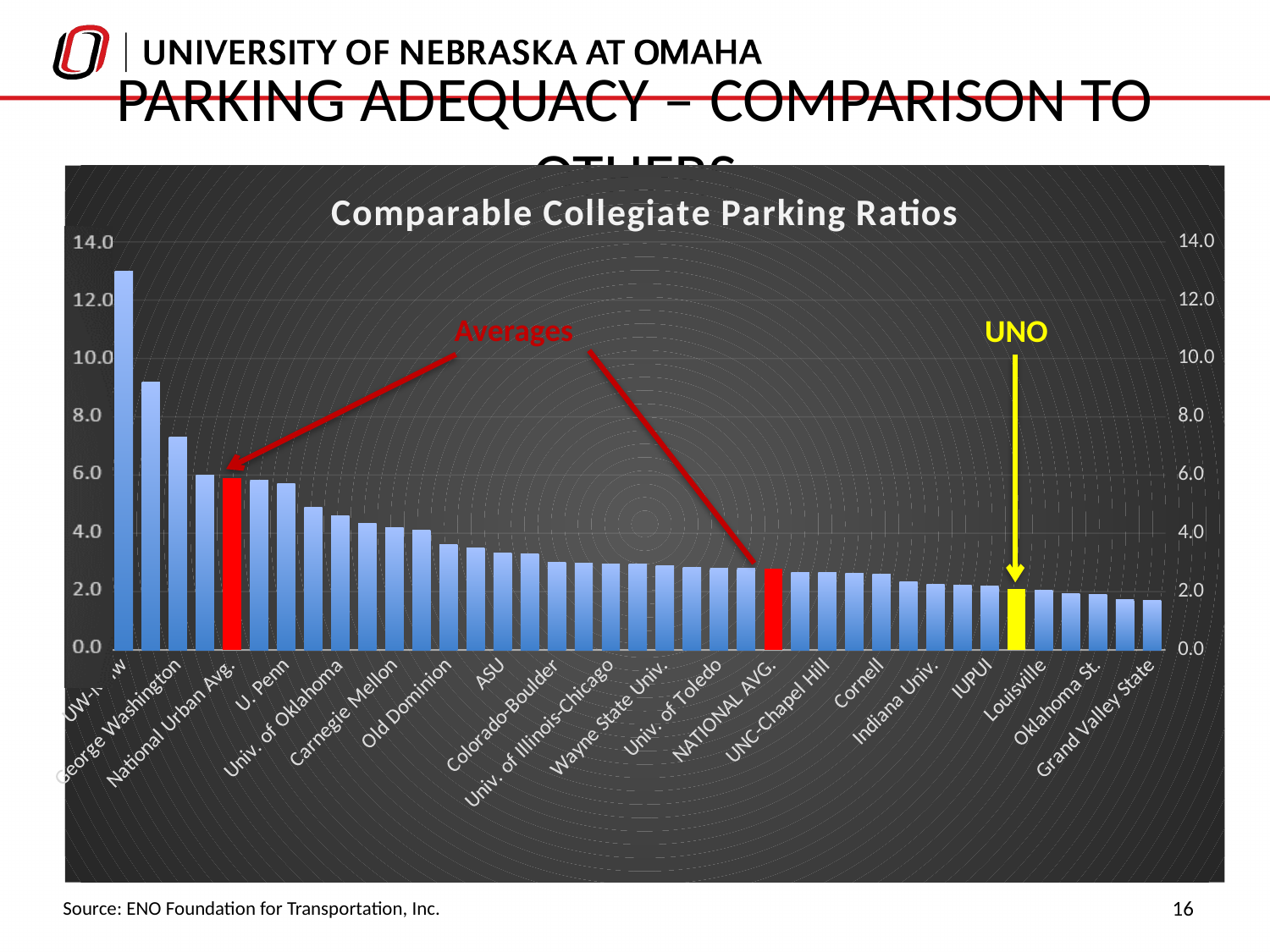
What is the title of the chart? Comparable Collegiate Parking Ratios Is the value for Grand Valley State greater or less than 2.0? less Is the value for ASU greater or less than 4.0? less Is the value for NATIONAL AVG. greater or less than 2.0? greater Which has the higher parking ratio, Carnegie Mellon or Cornell? Carnegie Mellon What colour is the bar for UNO? yellow Do the parking ratios rise or fall moving from left to right along the x axis? fall Which labelled institution has the lowest parking ratio? Grand Valley State What kind of chart is shown on the slide? bar chart Which has the higher parking ratio, George Washington or U. Penn? George Washington